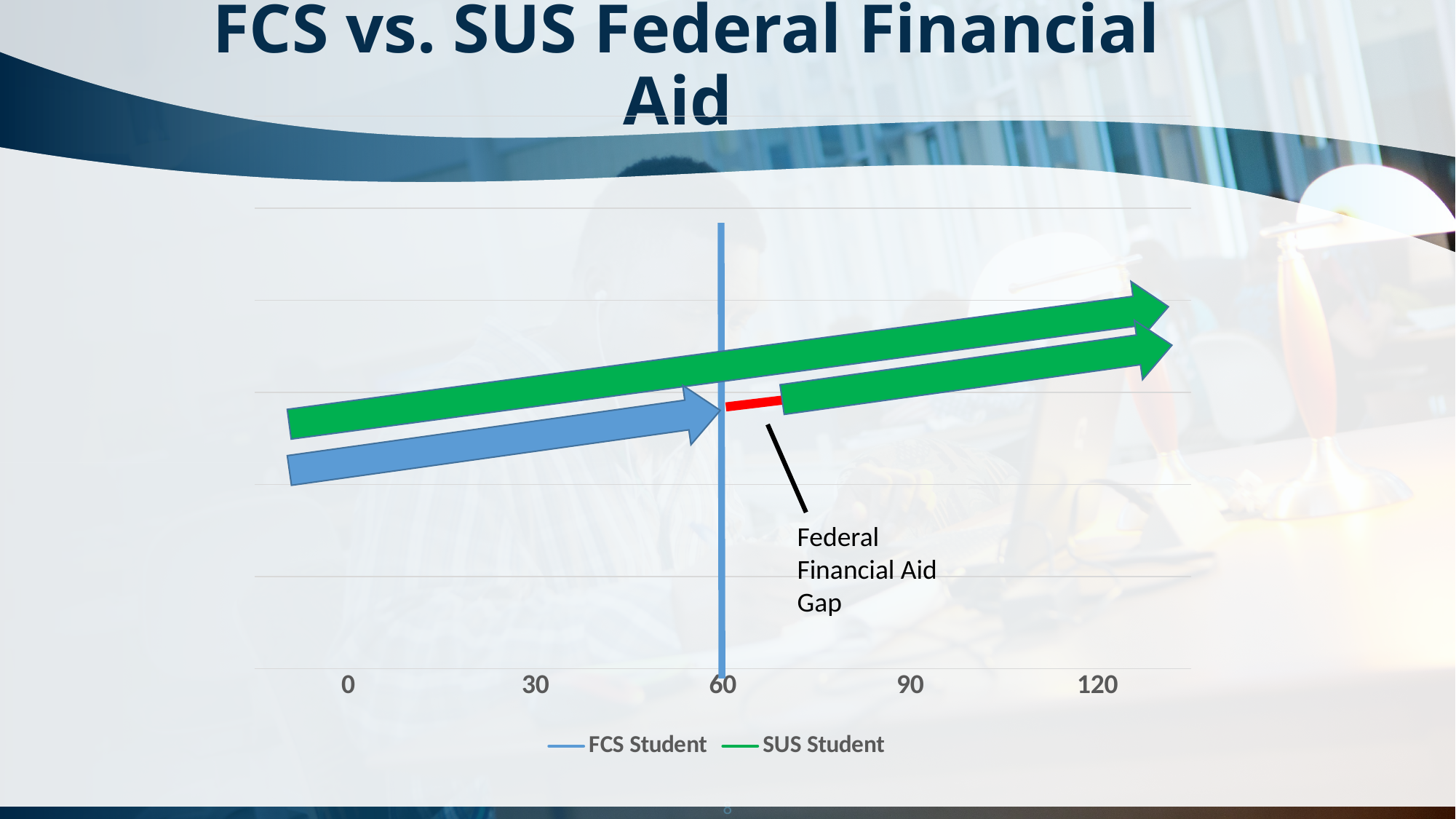
At which x-axis value is the vertical FCS Student line drawn? 60 What is the highest tick label shown on the x axis? 120 Is the x-axis position of the FCS Student line greater or less than 90? less What is the interval between consecutive tick labels on the x axis? 30 How many tick labels are shown on the x axis of the chart? 5 What is the lowest tick label shown on the x axis? 0 What is the title of the chart on the slide? FCS vs. SUS Federal Financial Aid Is the x-axis position of the FCS Student line greater or less than 30? greater How many series does the chart legend list? 2 What are the two series named in the chart legend? FCS Student and SUS Student